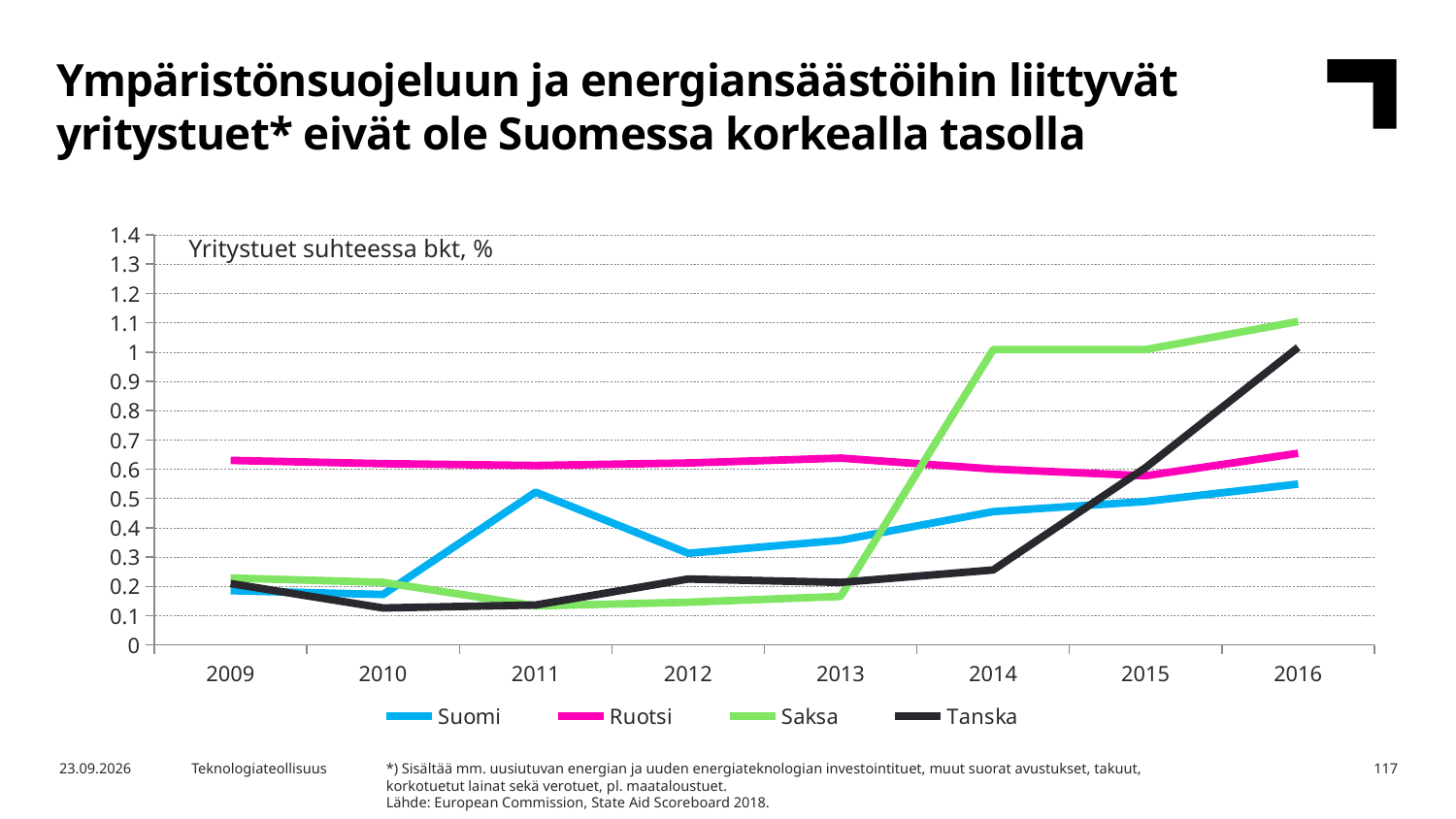
In 2009, which is larger: the value for Ruotsi or the value for Suomi? Ruotsi Is the value for Tanska in 2010 greater or less than 0.2? less Does the value for Saksa rise or fall from 2013 to 2016? Rises How many years are shown on the x axis? 8 Is the value for Saksa in 2016 greater or less than 1? greater Is the value for Ruotsi in 2013 greater or less than 0.6? greater What kind of chart is shown on the slide? Line chart Which country has the highest value in 2016? Saksa What is the title shown inside the chart area? Yritystuet suhteessa bkt, % How many series does the legend list? 4 Which country has the lowest value in 2016? Suomi